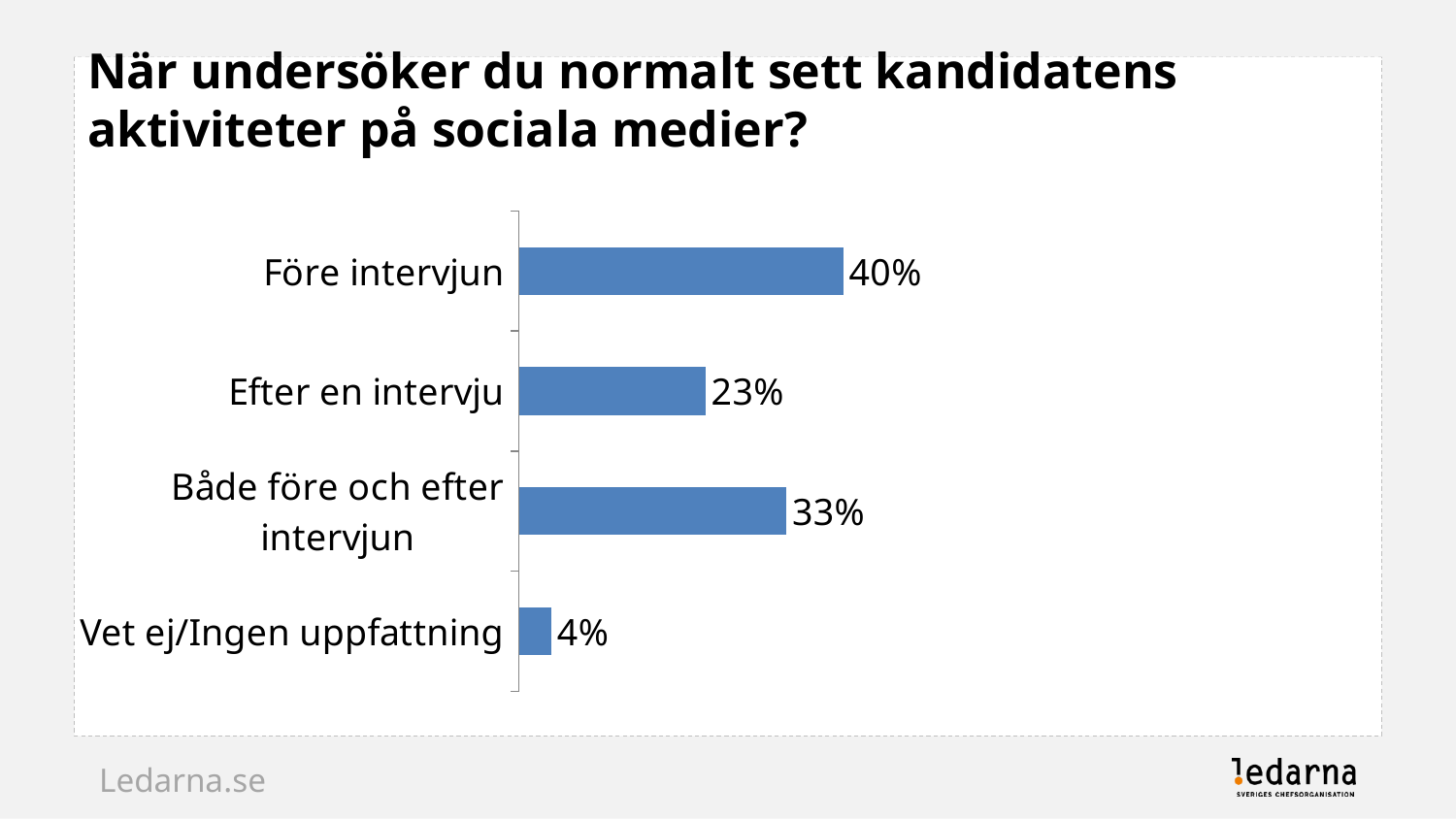
Which is larger: "Efter en intervju" or "Både före och efter intervjun"? Både före och efter intervjun Which category has the highest value? Före intervjun What is the title of the chart? När undersöker du normalt sett kandidatens aktiviteter på sociala medier? What is the value for "Både före och efter intervjun"? 33% How many categories are shown in the chart? 4 What is the value for "Vet ej/Ingen uppfattning"? 4% What is the difference between "Både före och efter intervjun" and "Vet ej/Ingen uppfattning"? 29% What is the difference between "Före intervjun" and "Efter en intervju"? 17% What is the value for "Efter en intervju"? 23% What is the value for "Före intervjun"? 40% What kind of chart is shown on the slide? Bar chart Which category has the lowest value? Vet ej/Ingen uppfattning